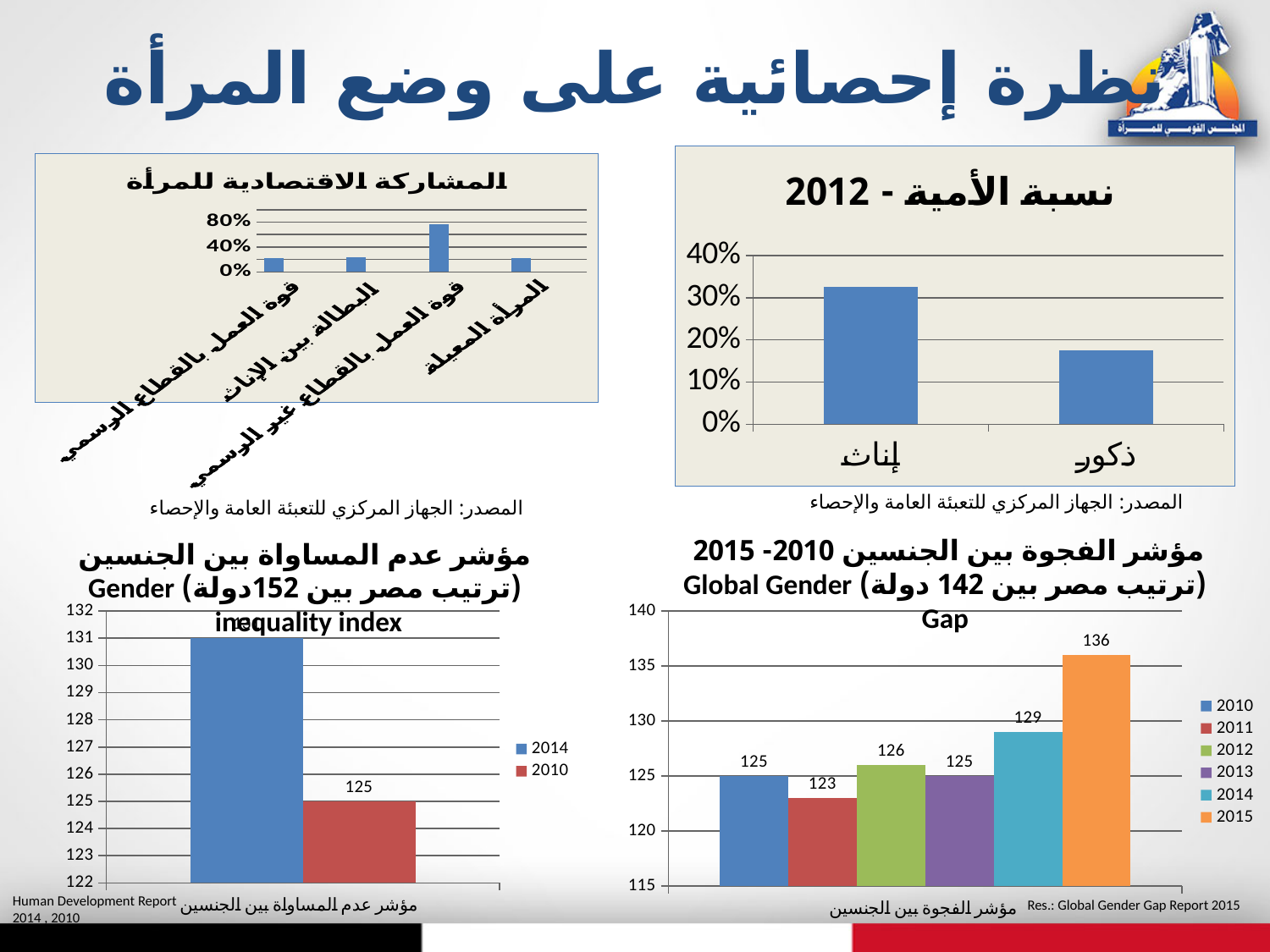
In the Global Gender Gap chart (مؤشر الفجوة بين الجنسين 2010-2015), which year has the lowest value? 2011 In the Global Gender Gap chart (مؤشر الفجوة بين الجنسين 2010-2015), what is the value for 2011? 123 How many series does the legend of the Global Gender Gap chart (مؤشر الفجوة بين الجنسين 2010-2015) list? 6 In the illiteracy rate chart (نسبة الأمية - 2012), is the value for إناث greater or less than 30%? greater In the Global Gender Gap chart (مؤشر الفجوة بين الجنسين 2010-2015), what is the difference between the 2015 value and the 2010 value? 11 How many categories are shown in the women's economic participation chart (المشاركة الاقتصادية للمرأة)? 4 What kind of chart is the illiteracy rate chart (نسبة الأمية - 2012)? bar chart In the Global Gender Gap chart (مؤشر الفجوة بين الجنسين 2010-2015), which year has the highest value? 2015 In the Gender inequality index chart (مؤشر عدم المساواة بين الجنسين), what is the value for 2010? 125 In the Gender inequality index chart (مؤشر عدم المساواة بين الجنسين), which is larger, the 2014 value or the 2010 value? 2014 In the Global Gender Gap chart (مؤشر الفجوة بين الجنسين 2010-2015), what is the value for 2015? 136 In the illiteracy rate chart (نسبة الأمية - 2012), is the value for ذكور greater or less than 20%? less